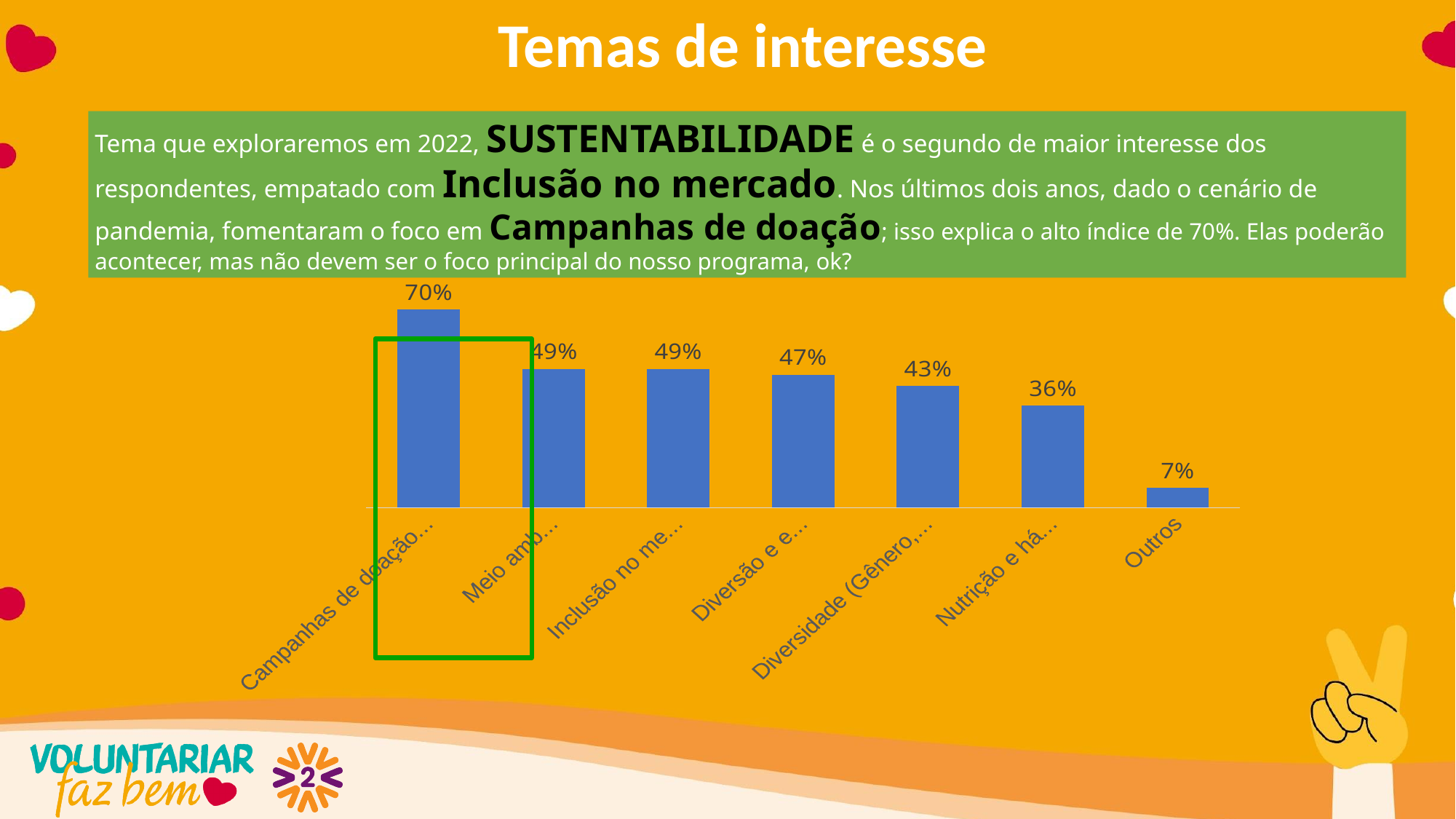
How many categories are shown in the bar chart? 7 What is the value for the category starting with 'Nutrição' in the bar chart? 36% What is the value for the category starting with 'Diversidade (Gênero' in the bar chart? 43% What is the difference between the value for Campanhas de doação and the value for Outros? 63% What is the value for Campanhas de doação in the bar chart? 70% Which category has the lowest value in the bar chart? Outros What is the value for Outros in the bar chart? 7% What is the difference between the value for Campanhas de doação and the value for the category starting with 'Nutrição'? 34% Which category has the highest value in the bar chart? Campanhas de doação Which is larger: the value for the category starting with 'Diversidade (Gênero' or the value for the category starting with 'Nutrição'? Diversidade (Gênero What kind of chart is shown on the slide? Bar chart Do the values rise or fall from left to right across the bar chart? Fall